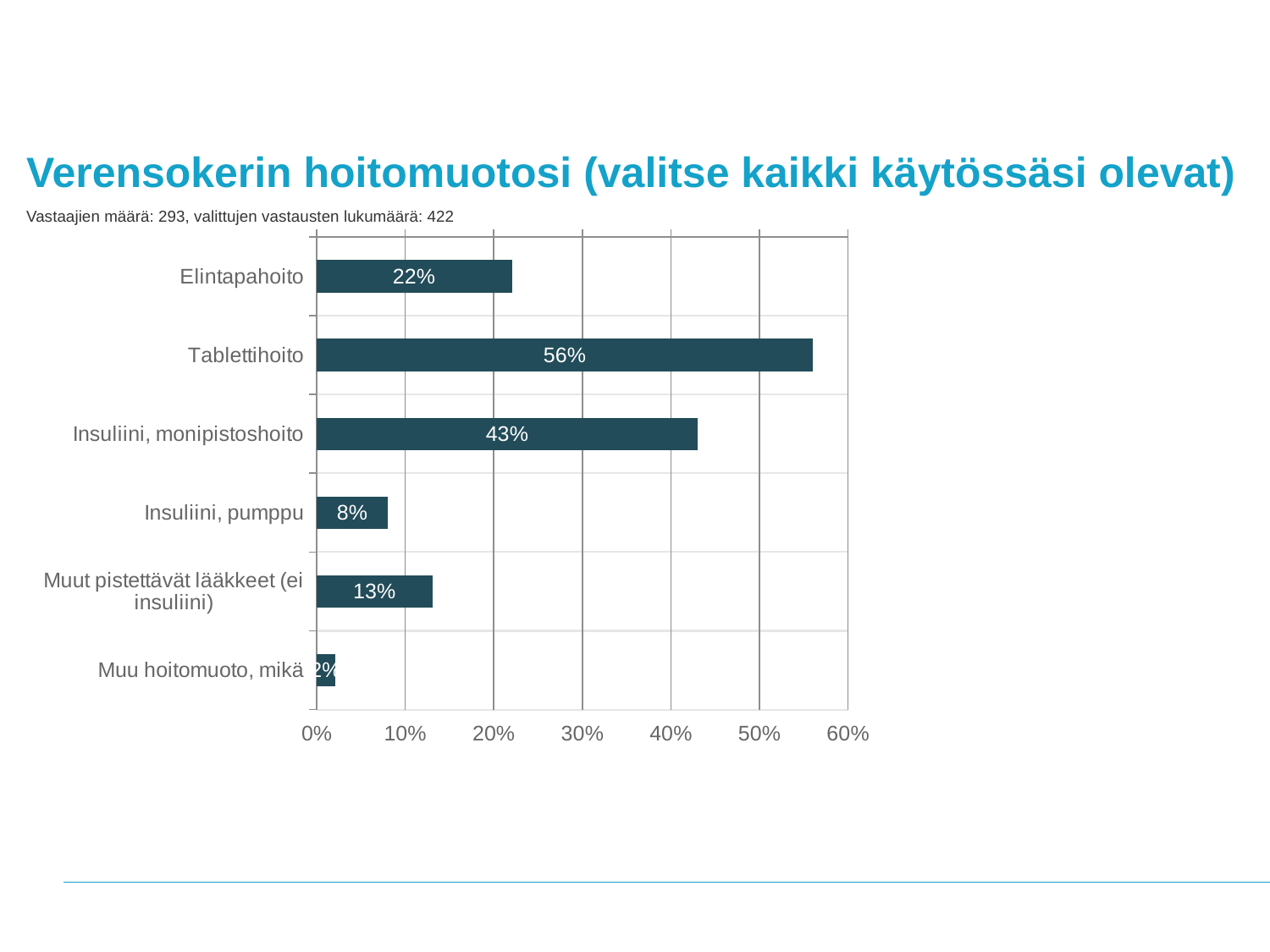
What is the value for Elintapahoito? 22% Which is larger, the value for Elintapahoito or the value for Muut pistettävät lääkkeet (ei insuliini)? Elintapahoito What is the value for Muut pistettävät lääkkeet (ei insuliini)? 13% What is the difference between the values for Tablettihoito and Insuliini, monipistoshoito? 13% Is the value for Muu hoitomuoto, mikä greater or less than 10%? less What kind of chart is shown on the slide? bar chart What is the value for Tablettihoito? 56% What is the value for Insuliini, monipistoshoito? 43% Which category has the highest value? Tablettihoito What is the value for Insuliini, pumppu? 8% Which category has the lowest value? Muu hoitomuoto, mikä How many categories are shown in the chart? 6